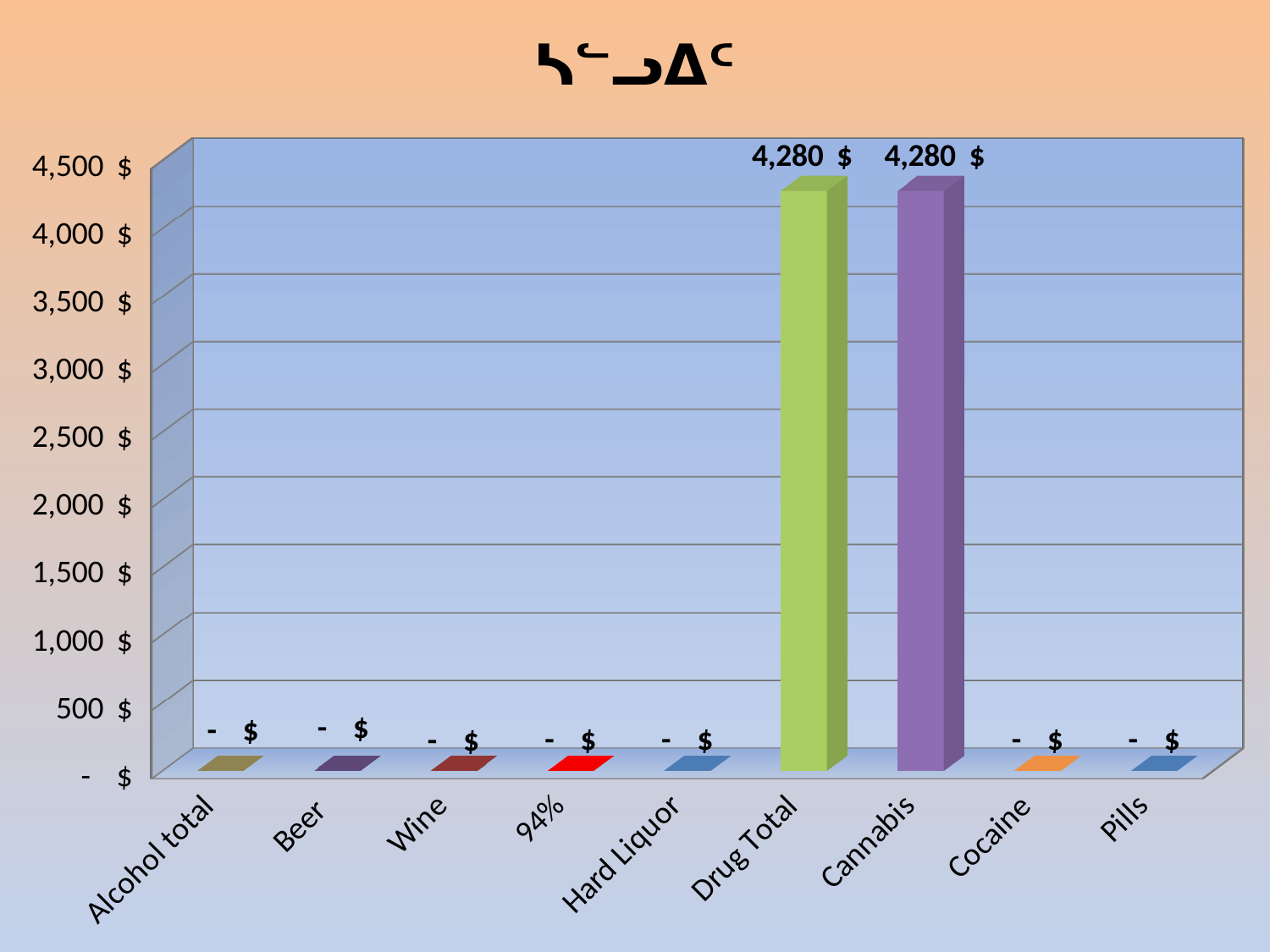
What is the value for Drug Total? 4,280 $ What kind of chart is shown on the slide? Bar chart What value is shown for Cocaine? - $ What is the value for Cannabis? 4,280 $ What value is shown for Beer? - $ What is the difference between the values for Cannabis and Cocaine? 4,280 $ Which two categories share the highest value? Drug Total and Cannabis What colour is the bar for Drug Total? Green Is the value for Drug Total greater or less than 4,000? greater Which is larger, the value for Cannabis or the value for Pills? Cannabis Is the value for Wine greater or less than 500? less How many categories are shown on the x axis? 9